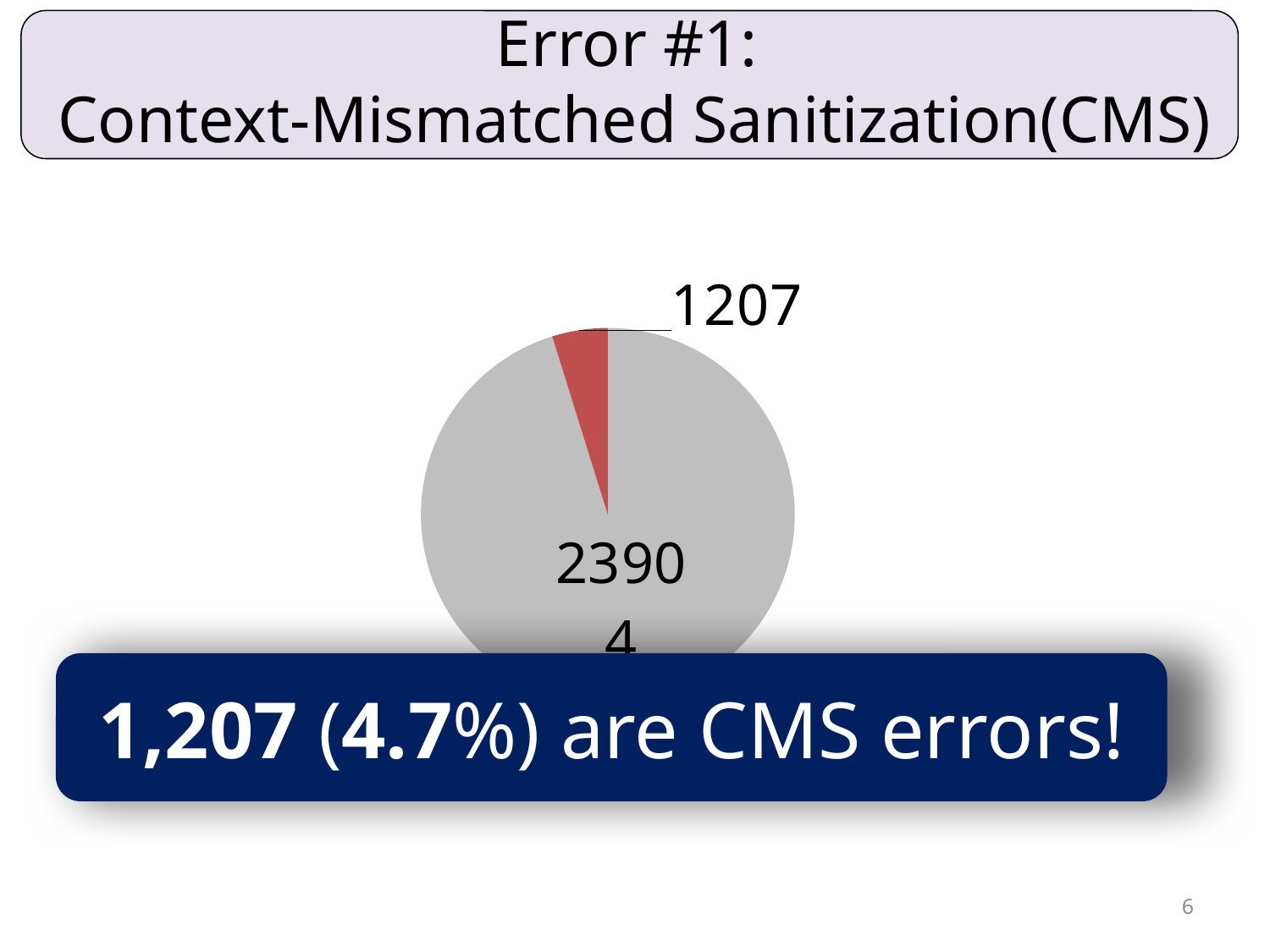
What value is labelled on the red slice of the pie chart? 1207 What colour is the slice representing the CMS errors in the pie chart? red Which slice of the pie chart is the smallest? the red slice (1207) What is the title shown at the top of the slide? Error #1: Context-Mismatched Sanitization(CMS) What type of chart is shown on the slide? pie chart According to the slide, what percentage of the total do the 1,207 CMS errors represent? 4.7% Which slice of the pie chart is larger, the red slice or the grey slice? the grey slice How many slices does the pie chart have? 2